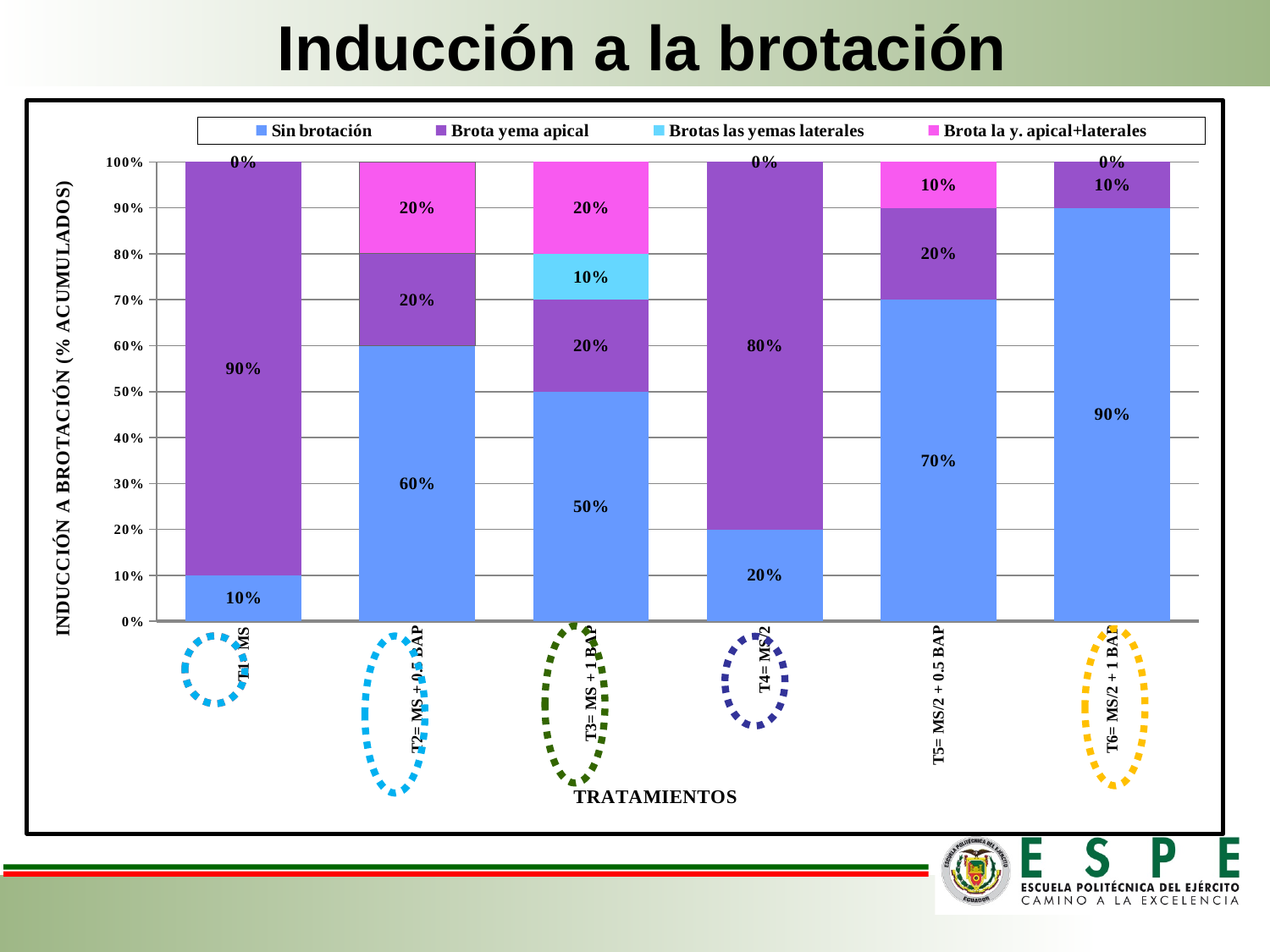
What is the difference between the 'Sin brotación' values for T2= MS + 0.5 BAP and T3= MS + 1 BAP? 10% What is the value of 'Brotas las yemas laterales' for T3= MS + 1 BAP? 10% What is the value of 'Brota yema apical' for T4= MS/2? 80% What is the value of 'Brota la y. apical+laterales' for T5= MS/2 + 0.5 BAP? 10% What is the value of 'Sin brotación' for T1= MS? 10% What is the label of the y axis? INDUCCIÓN A BROTACIÓN (% ACUMULADOS) How many treatments (categories) are plotted on the x axis? 6 Which treatment has the lowest value for 'Sin brotación'? T1= MS Which treatment has the highest value for 'Sin brotación'? T6= MS/2 + 1 BAP What kind of chart is shown on the slide? stacked bar chart How many series does the legend list? 4 Which is larger, the 'Brota yema apical' value for T1= MS or for T4= MS/2? T1= MS